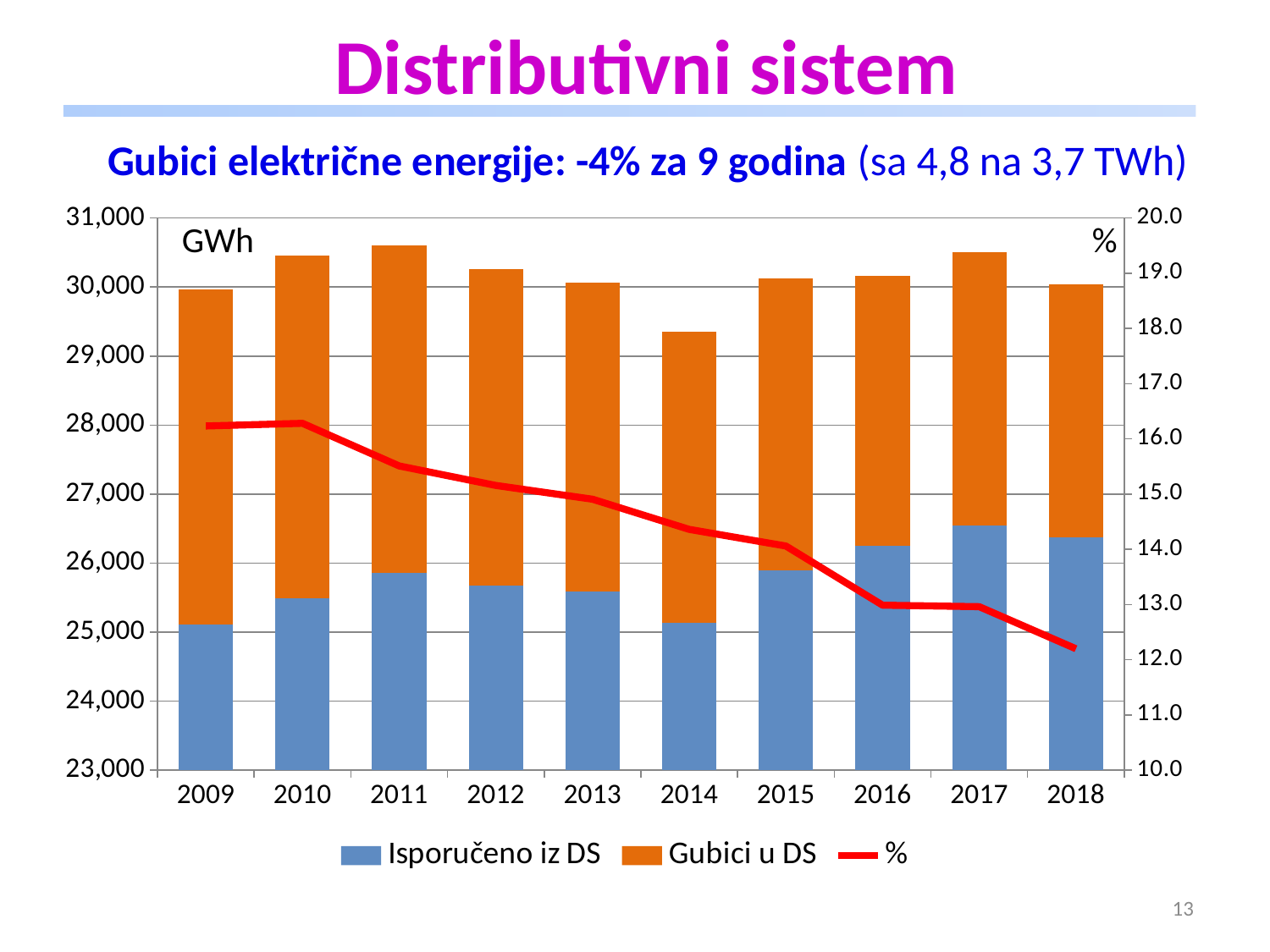
Does the % line rise or fall from 2009 to 2018? Fall What unit is shown on the left axis of the chart? GWh How many years are shown on the x axis of the chart? 10 Is the Isporučeno iz DS value for 2017 greater or less than 26,000? greater In which year is the % line at its lowest? 2018 In which year is the total stacked bar the lowest? 2014 In which year is the Isporučeno iz DS bar the highest? 2017 What kind of chart is shown on the slide? A stacked bar chart with a line How many series does the chart legend list? 3 Which year has the larger Isporučeno iz DS value, 2009 or 2016? 2016 Is the % value for 2018 greater or less than 13.0? less What are the three series listed in the chart legend? Isporučeno iz DS, Gubici u DS, %